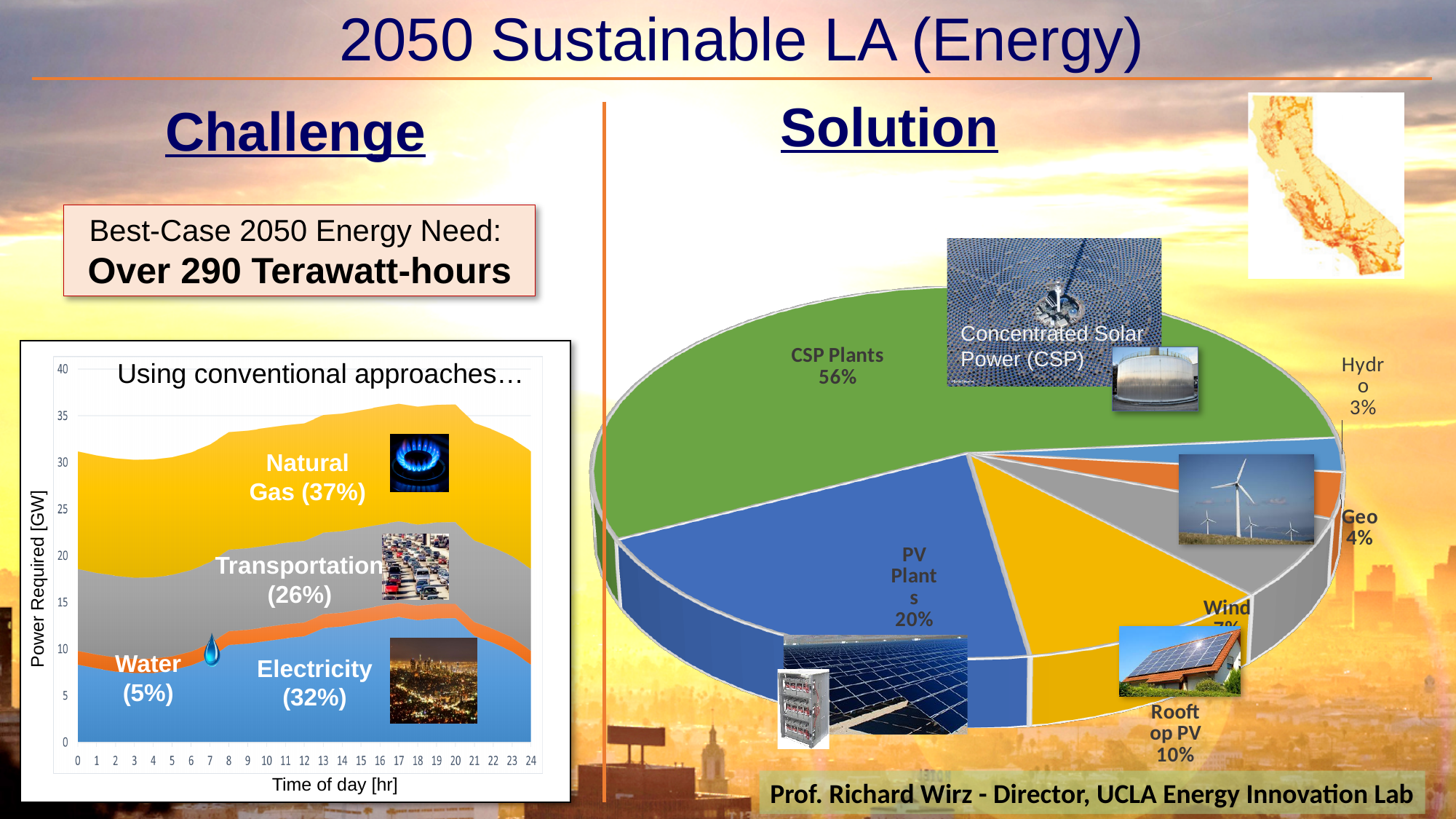
On the left 'Using conventional approaches…' chart, which has the larger share, Electricity or Transportation? Electricity On the Solution pie chart, how many slices are there? 6 On the Solution pie chart, what share is labelled for Hydro? 3% On the left 'Using conventional approaches…' chart, what percentage is labelled for Natural Gas? 37% On the Solution pie chart, how many percentage points larger is the CSP Plants share than the PV Plants share? 36 percentage points What kind of chart is the 'Using conventional approaches…' chart on the left? Stacked area chart On the Solution pie chart, which source has the smallest slice? Hydro On the Solution pie chart, which source has the largest slice? CSP Plants On the Solution pie chart, what share is labelled for PV Plants? 20% On the Solution pie chart, what share is labelled for Rooftop PV? 10% On the left 'Using conventional approaches…' chart, what is the y-axis label? Power Required [GW] On the Solution pie chart, what share is labelled for CSP Plants? 56%